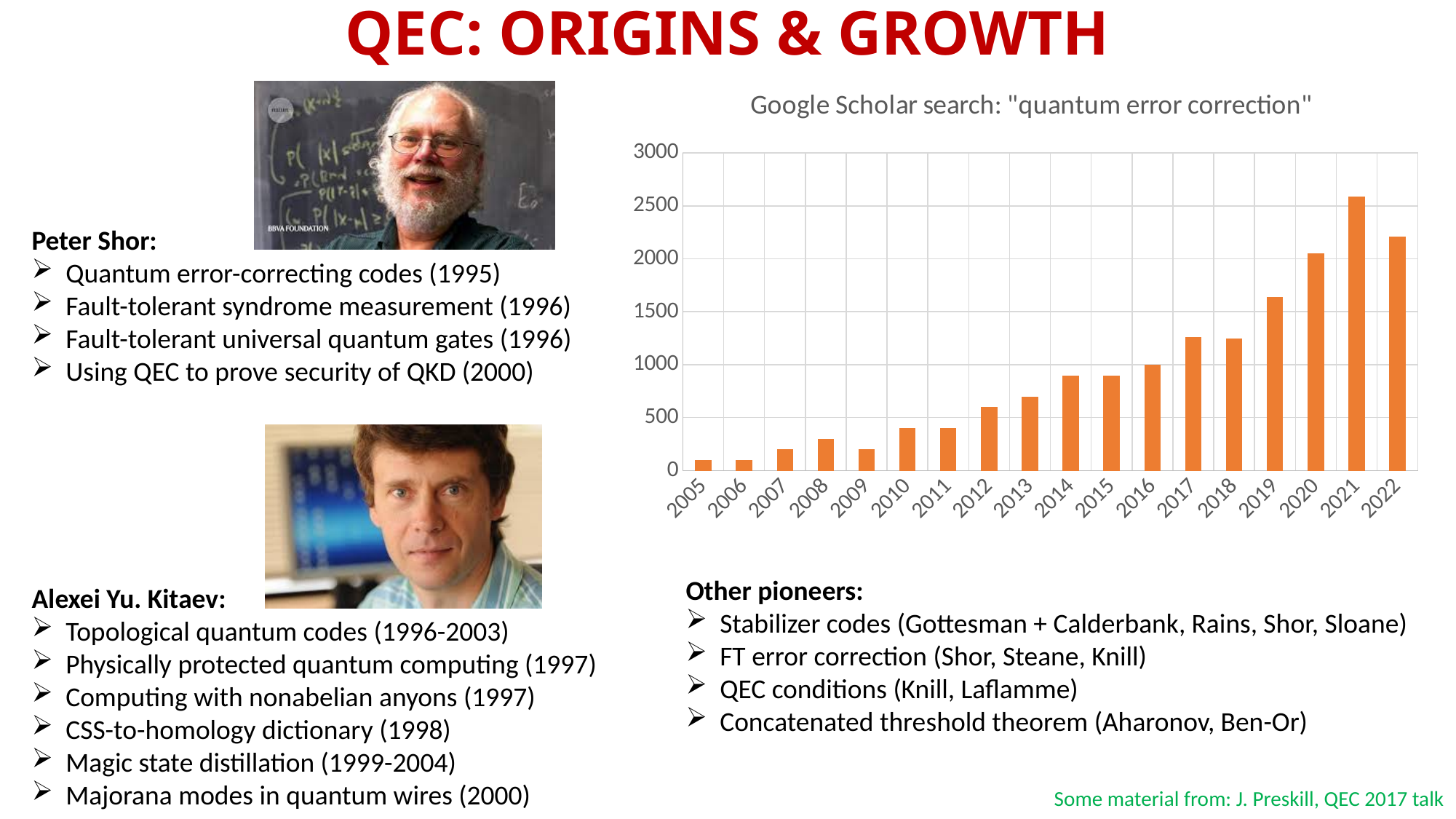
Is the value for 2022 greater or less than 2000? greater What kind of chart is shown on the slide? bar chart Is the value for 2019 greater or less than 1500? greater Do the values generally rise or fall from 2005 to 2021? rise Which year has the highest bar in the chart? 2021 Is the value for 2013 greater or less than 1000? less What is the title of the chart? Google Scholar search: "quantum error correction" Which year has the larger value, 2021 or 2022? 2021 How many years are shown on the x axis of the chart? 18 Which year has the larger value, 2019 or 2020? 2020